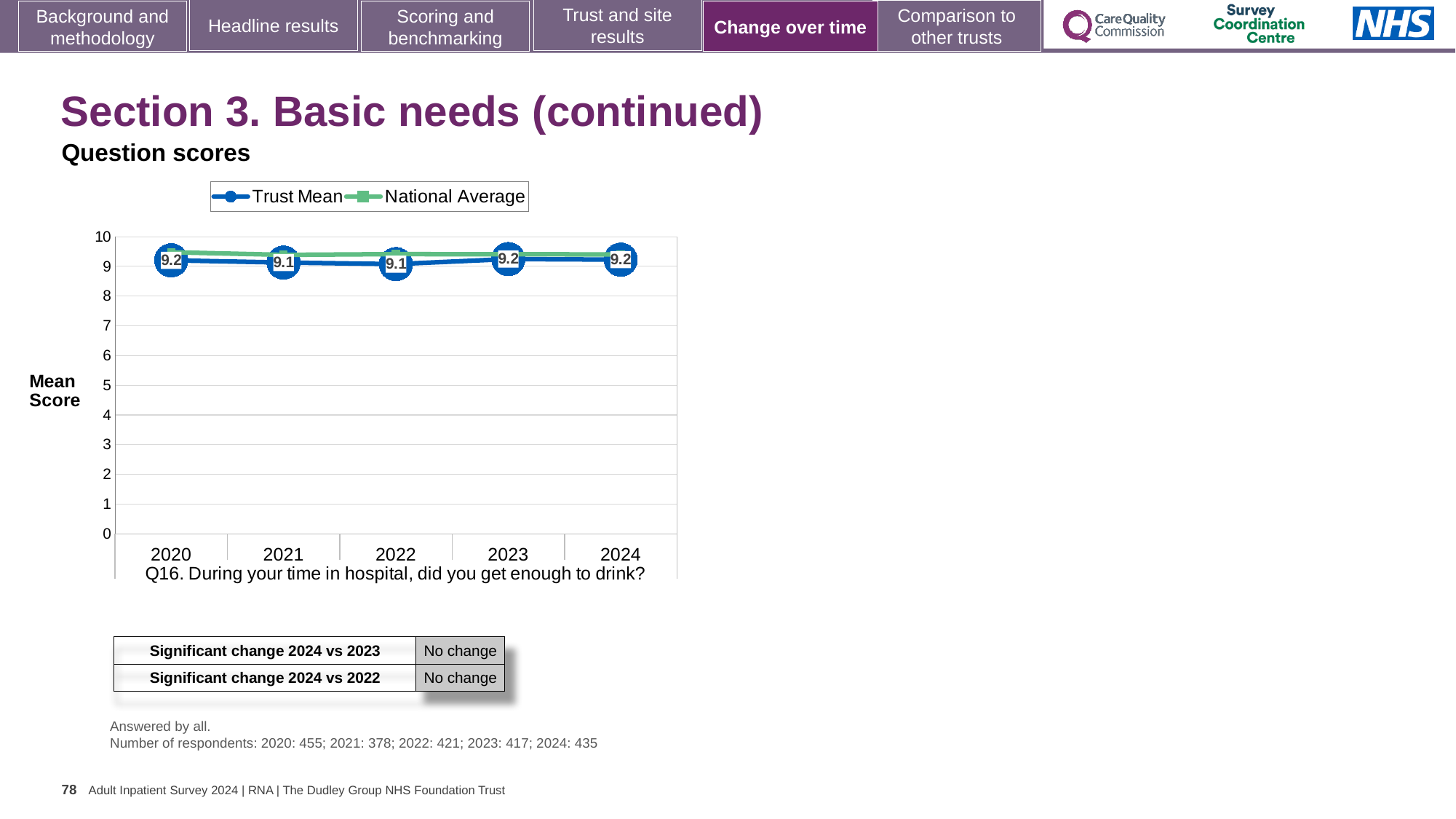
What is the Trust Mean score for 2021? 9.1 Which year has the larger Trust Mean score, 2021 or 2023? 2023 Is the National Average value for 2020 greater or less than 9? greater What is the Trust Mean score for 2022? 9.1 Which survey question does the chart show scores for? Q16. During your time in hospital, did you get enough to drink? What kind of chart is shown on the slide? Line chart Does the Trust Mean score rise or fall from 2022 to 2024? Rise How many series does the legend list? 2 What is the Trust Mean score for 2024? 9.2 What is the Trust Mean score for 2020? 9.2 How many years are plotted on the x axis? 5 What is the difference between the Trust Mean score in 2020 and in 2021? 0.1